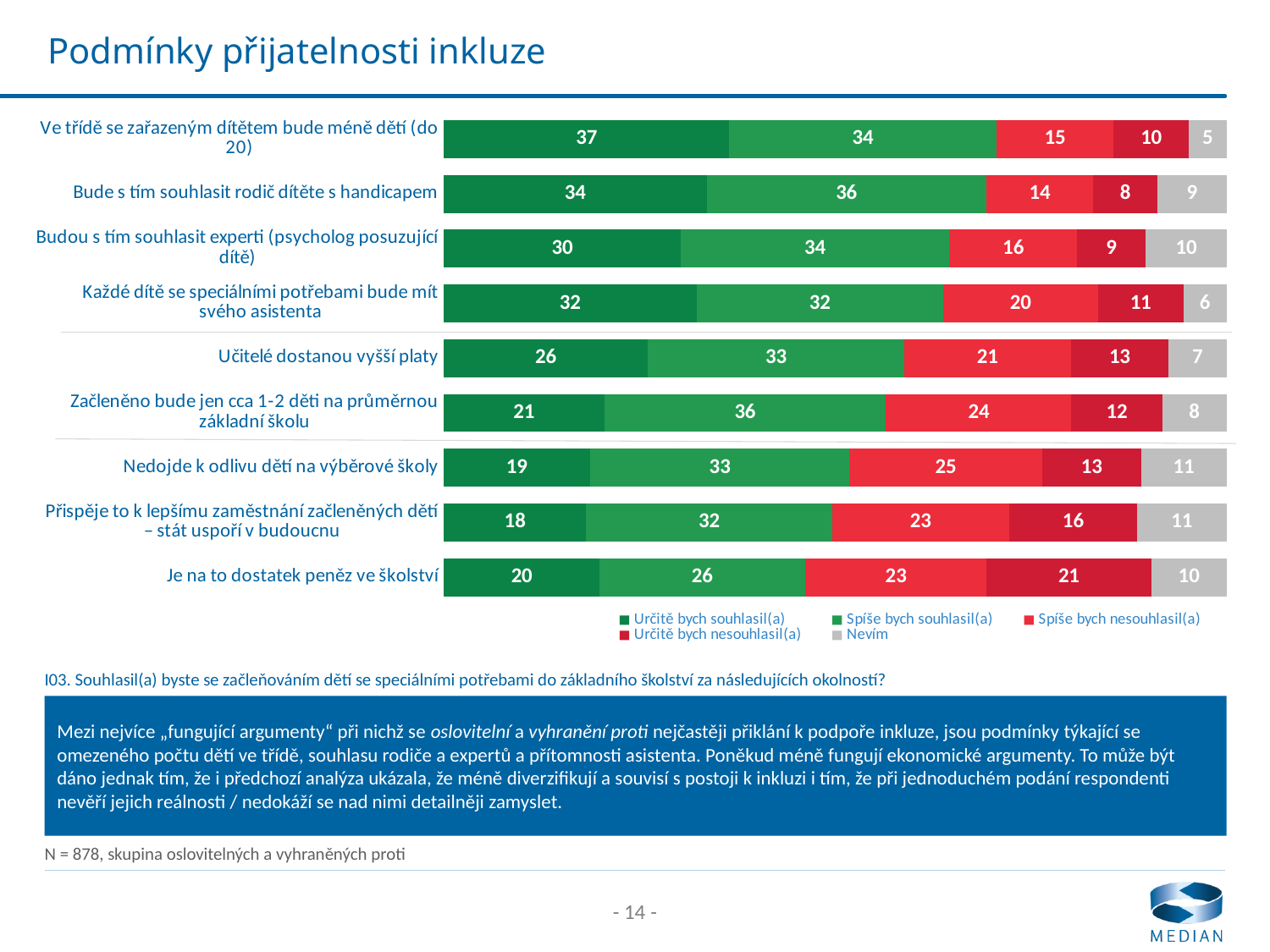
How many categories are shown in the chart? 9 Which category has the highest value for "Určitě bych souhlasil(a)"? Ve třídě se zařazeným dítětem bude méně dětí (do 20) How many series does the legend list? 5 Which is larger: the "Spíše bych souhlasil(a)" value for "Začleněno bude jen cca 1-2 děti na průměrnou základní školu" or for "Je na to dostatek peněz ve školství"? Začleněno bude jen cca 1-2 děti na průměrnou základní školu What is the value of "Spíše bych nesouhlasil(a)" for "Nedojde k odlivu dětí na výběrové školy"? 25 Which category has the lowest value for "Určitě bych souhlasil(a)"? Přispěje to k lepšímu zaměstnání začleněných dětí – stát uspoří v budoucnu What is the value of "Určitě bych souhlasil(a)" for "Ve třídě se zařazeným dítětem bude méně dětí (do 20)"? 37 What is the value of "Nevím" for "Budou s tím souhlasit experti (psycholog posuzující dítě)"? 10 What is the difference between the "Určitě bych souhlasil(a)" values for "Bude s tím souhlasit rodič dítěte s handicapem" and "Učitelé dostanou vyšší platy"? 8 What is the total of the stacked bar for "Učitelé dostanou vyšší platy"? 100 Which category has the highest value for "Určitě bych nesouhlasil(a)"? Je na to dostatek peněz ve školství What kind of chart is shown on the slide? Stacked bar chart